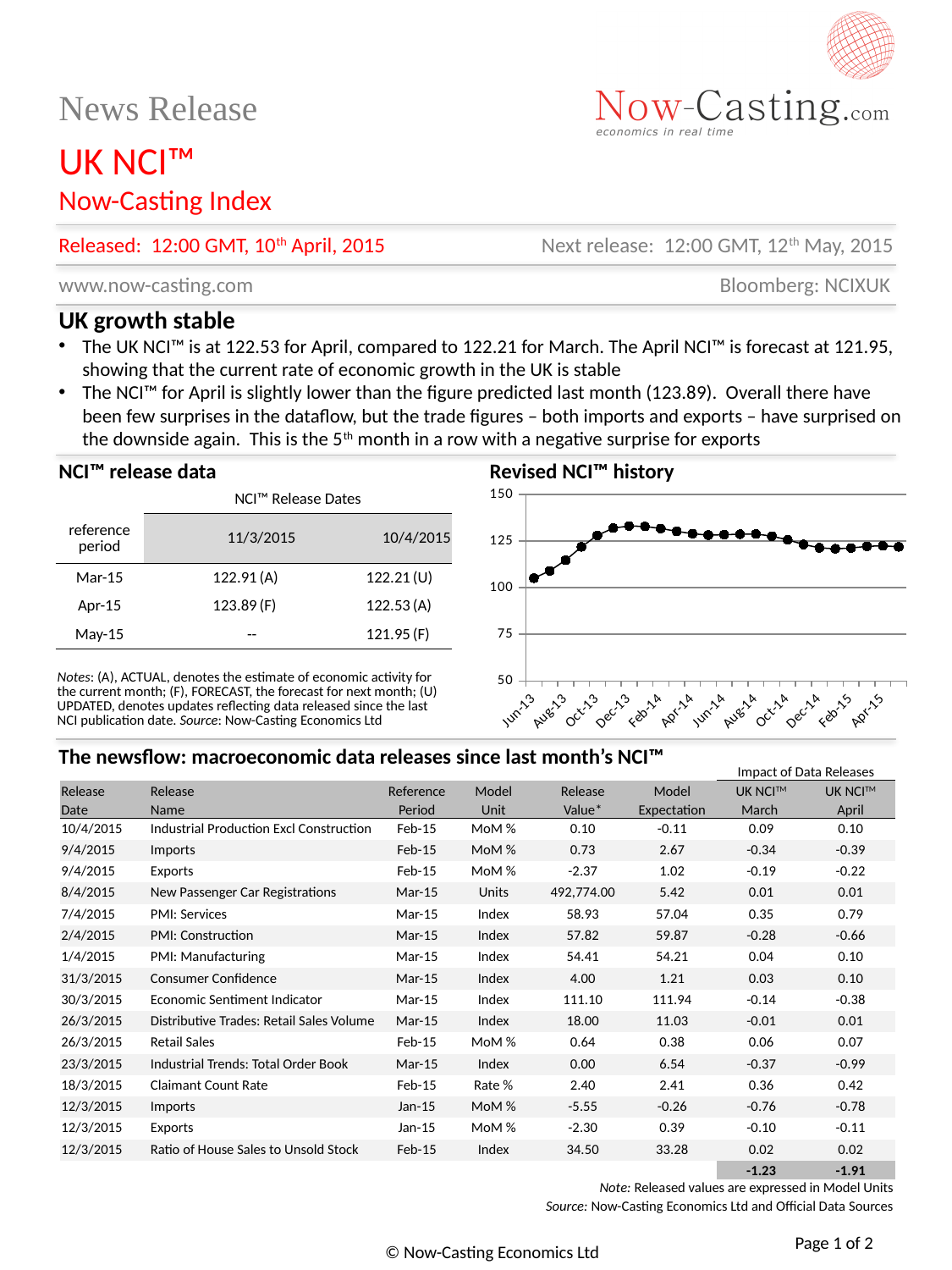
In the "Revised NCI™ history" chart, is the value for Dec-13 greater or less than 125? greater In the "Revised NCI™ history" chart, which month has the lowest value? Jun-13 What is the title of the chart on the slide? Revised NCI™ history How many month labels are shown on the x axis of the "Revised NCI™ history" chart? 12 What is the highest value shown on the y axis of the "Revised NCI™ history" chart? 150 In the "Revised NCI™ history" chart, do the values rise or fall from Jun-13 to Dec-13? rise In the "Revised NCI™ history" chart, which is larger, the value for Dec-13 or the value for Apr-15? Dec-13 In the "Revised NCI™ history" chart, is the value for Jun-13 greater or less than 100? greater In the "Revised NCI™ history" chart, which is larger, the value for Jun-13 or the value for Apr-15? Apr-15 In the "Revised NCI™ history" chart, is the value for Jun-13 greater or less than 125? less What kind of chart is the "Revised NCI™ history" chart? line chart